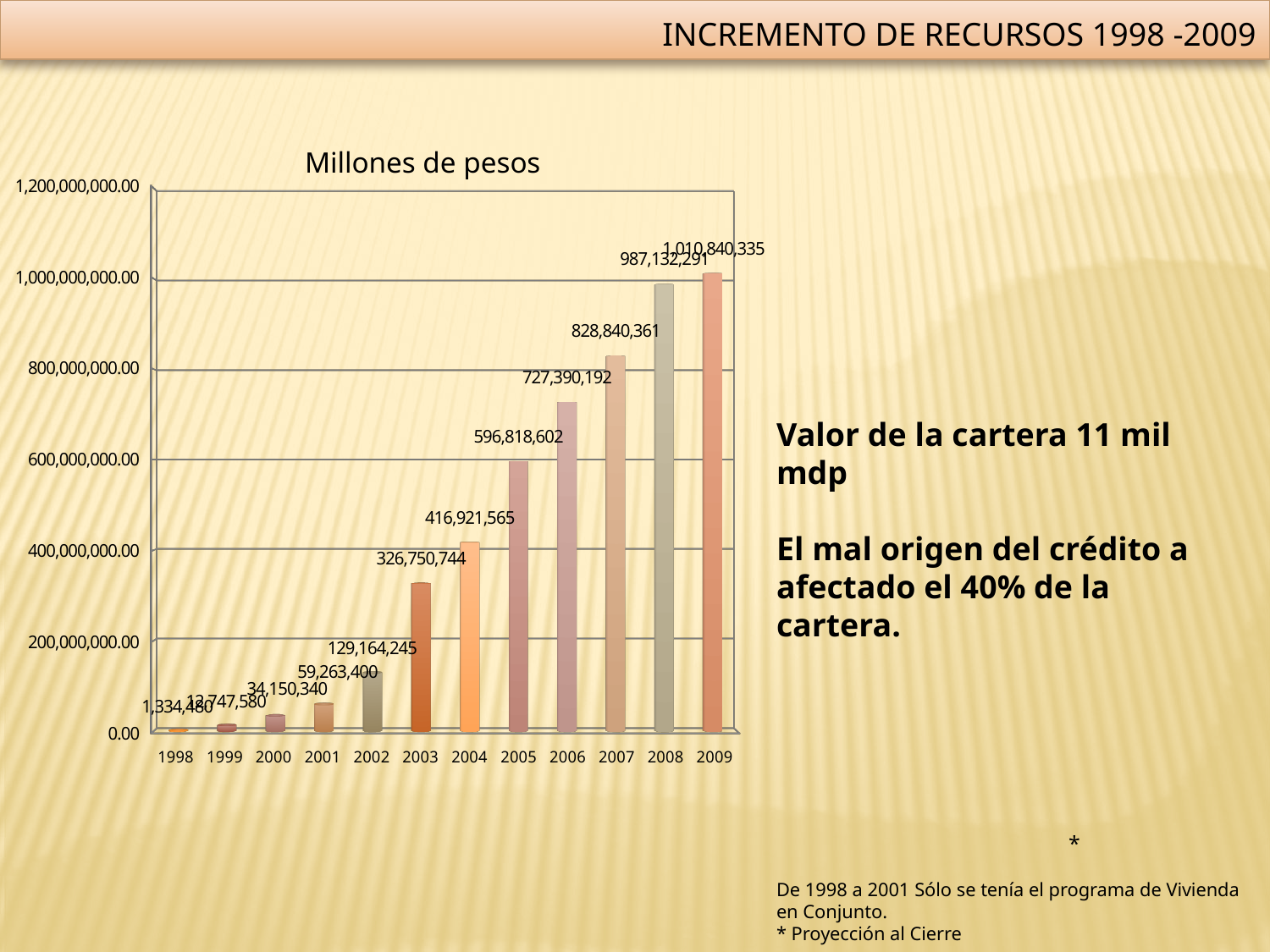
How many years are shown on the x axis? 12 Which year has the lowest value? 1998 What is the difference between the values for 2009 and 2008? 23,708,044 What is the value for 2009? 1,010,840,335 What is the value for 2005? 596,818,602 What is the value for 2007? 828,840,361 Do the values rise or fall from 1998 to 2009? rise Is the value for 2006 greater or less than 600,000,000.00? greater What is the value for 2002? 129,164,245 Which year has the highest value? 2009 Which is larger, the value for 2003 or the value for 2004? 2004 What is the difference between the values for 2007 and 2006? 101,450,169